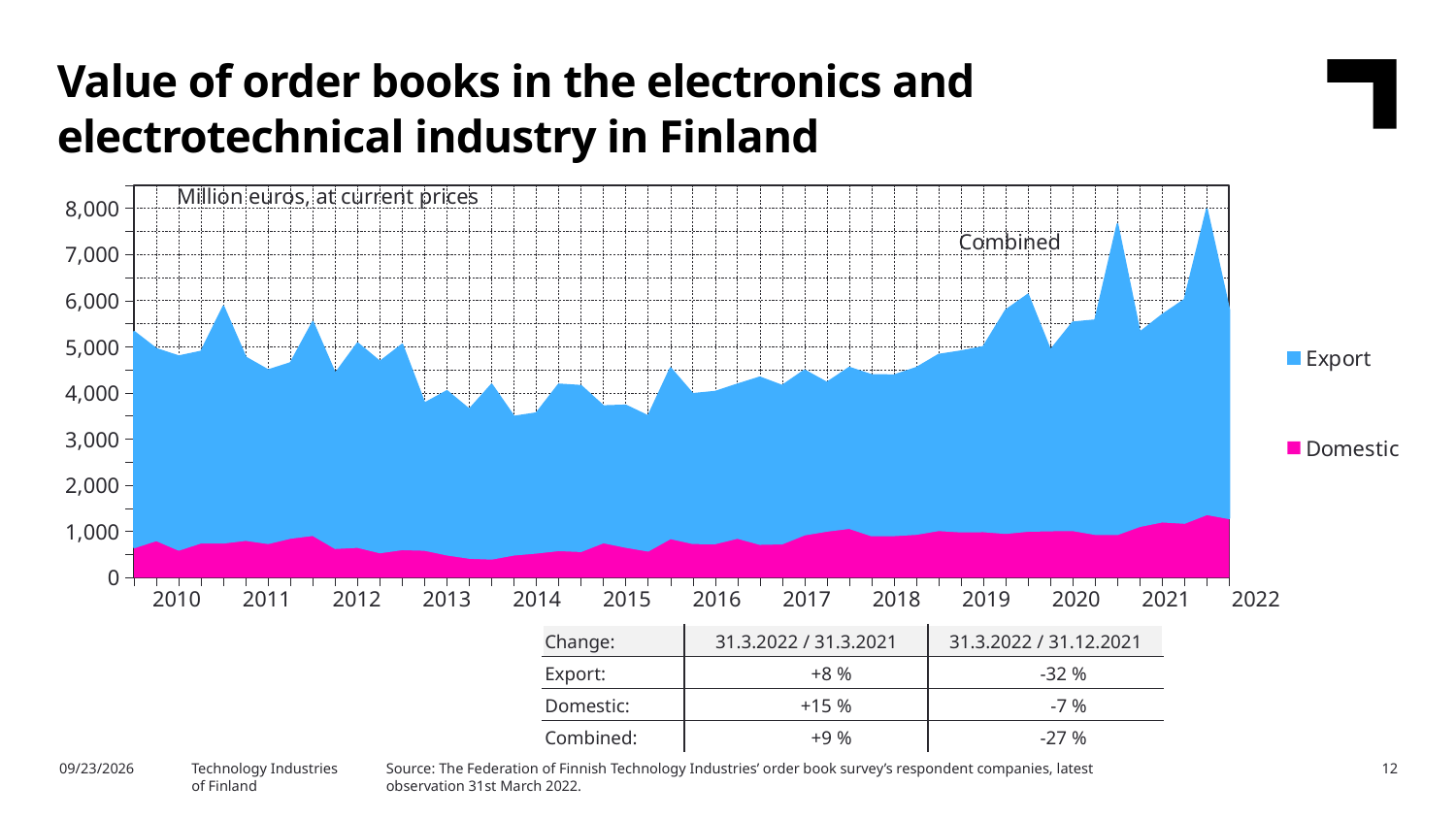
How many year labels are shown on the x axis of the chart? 13 Does the combined value of order books rise or fall from 2010 to 2014? fall What unit is stated for the values in the chart? Million euros, at current prices Is the combined value of order books at the start of 2010 greater or less than 5,000? greater Which two series are listed in the chart's legend? Export and Domestic Is the Domestic value at any point in the chart greater or less than 2,000? less Which series, Export or Domestic, accounts for the larger part of the combined order books throughout the chart? Export Does the Domestic series generally rise or fall from 2010 to 2022? rise Is the combined value at the peak in 2020 greater or less than 7,000? greater What kind of chart is shown on the slide? Stacked area chart How many series does the chart's legend list? 2